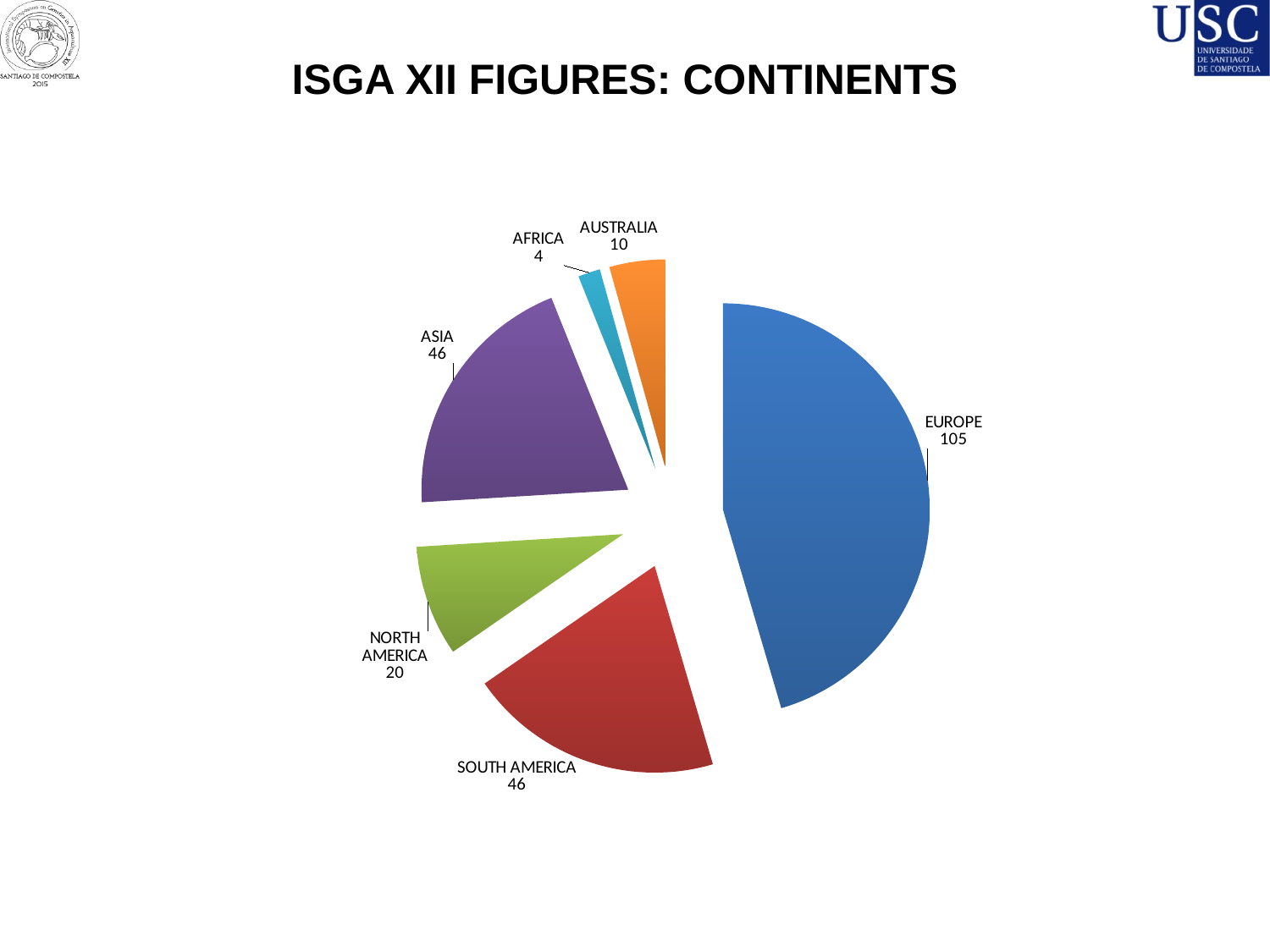
What is the value for EUROPE? 105 How many continents are shown in the pie chart? 6 Which continent has the smallest slice? AFRICA What is the value for NORTH AMERICA? 20 What is the value for AUSTRALIA? 10 What is the difference between the values for EUROPE and SOUTH AMERICA? 59 Which is larger, the value for ASIA or the value for NORTH AMERICA? ASIA What is the title of the slide containing the chart? ISGA XII FIGURES: CONTINENTS What is the value for ASIA? 46 What kind of chart is shown on the slide? pie chart Which continent has the largest slice? EUROPE What is the difference between the values for NORTH AMERICA and AUSTRALIA? 10